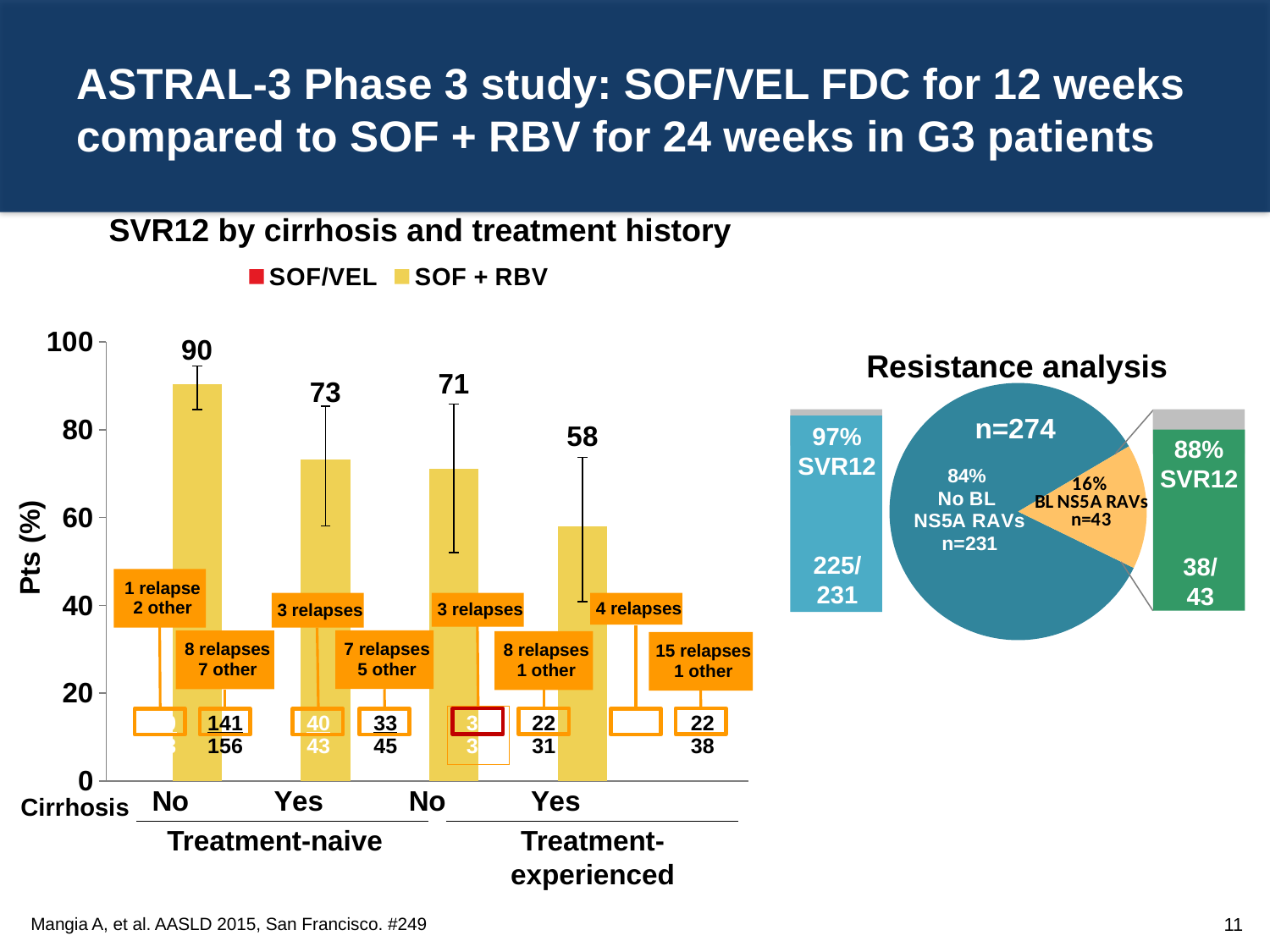
In the 'Resistance analysis' pie chart, what share of patients had baseline NS5A RAVs? 16% In the 'SVR12 by cirrhosis and treatment history' chart, which patient group has the lowest SOF + RBV SVR12 rate? Treatment-experienced, cirrhosis Yes In the 'SVR12 by cirrhosis and treatment history' chart, which patient group has the highest SOF + RBV SVR12 rate? Treatment-naive, cirrhosis No What is the total number of patients shown in the 'Resistance analysis' pie chart? n=274 In the 'Resistance analysis' pie chart, how many patients had no baseline NS5A RAVs? n=231 In the 'SVR12 by cirrhosis and treatment history' chart, what is the SVR12 rate for SOF + RBV in treatment-naive patients with cirrhosis? 73 How many series does the legend of the 'SVR12 by cirrhosis and treatment history' chart list? 2 In the 'SVR12 by cirrhosis and treatment history' chart, what is the SVR12 rate for SOF + RBV in treatment-experienced patients with cirrhosis? 58 In the 'SVR12 by cirrhosis and treatment history' chart, what is the difference between the SOF + RBV SVR12 rates for treatment-naive patients without cirrhosis and treatment-experienced patients with cirrhosis? 32 In the 'SVR12 by cirrhosis and treatment history' chart, what is the SVR12 rate for SOF + RBV in treatment-naive patients without cirrhosis? 90 What type of chart is the 'SVR12 by cirrhosis and treatment history' chart? Bar chart